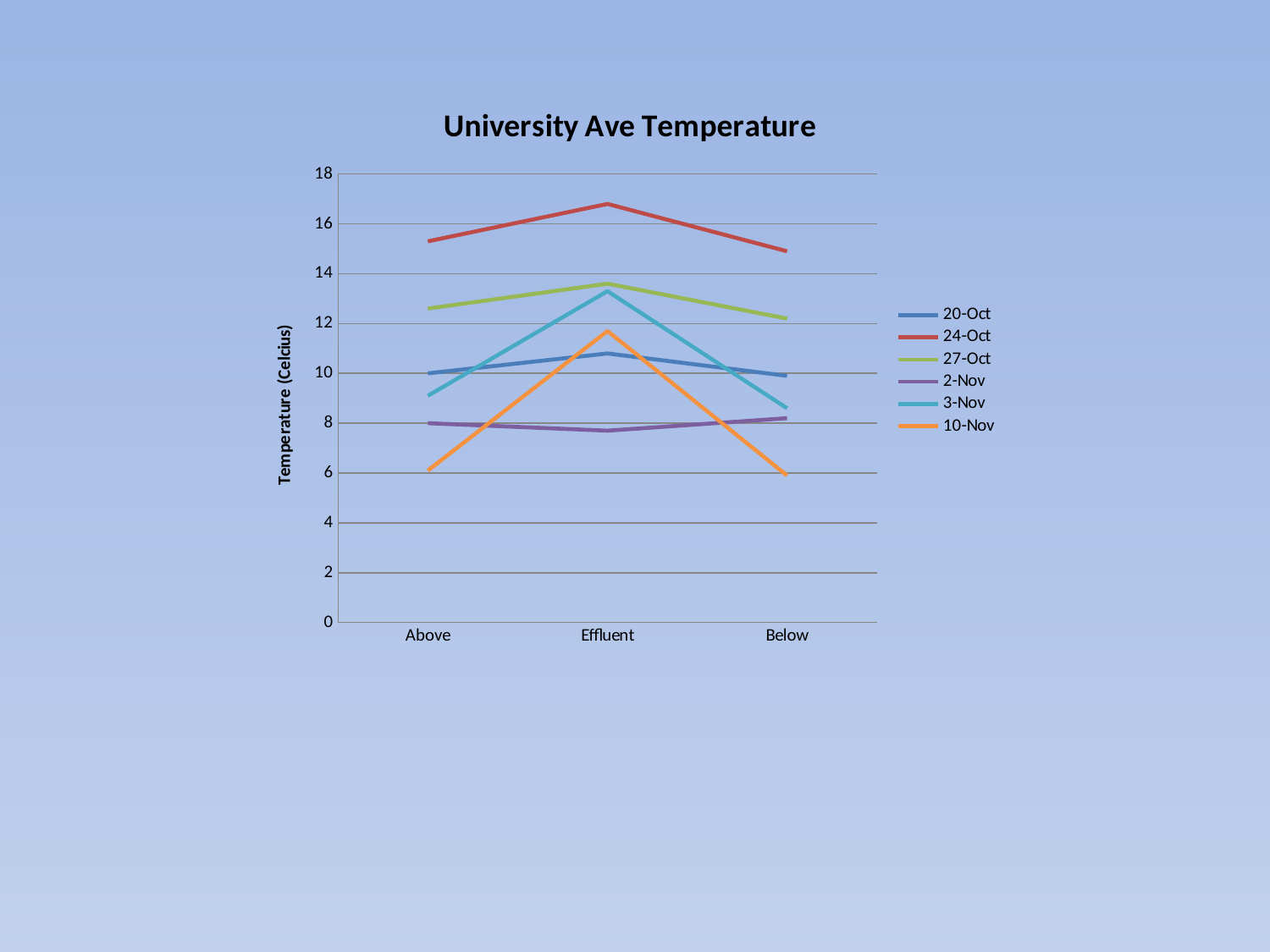
What kind of chart is shown on the slide? line chart Which series has the highest temperature at Effluent? 24-Oct How many categories are shown on the x axis? 3 Is the 24-Oct value at Effluent greater or less than 16? greater At Effluent, which series has the higher temperature, 10-Nov or 20-Oct? 10-Nov Does the 10-Nov series rise or fall from Effluent to Below? fall Is the 10-Nov value at Above greater or less than 8? less Which series has the lowest temperature at Above? 10-Nov Is the 3-Nov value at Below greater or less than 10? less At Above, which series has the higher temperature, 3-Nov or 27-Oct? 27-Oct What is the title of the y axis? Temperature (Celcius) How many series does the legend list? 6